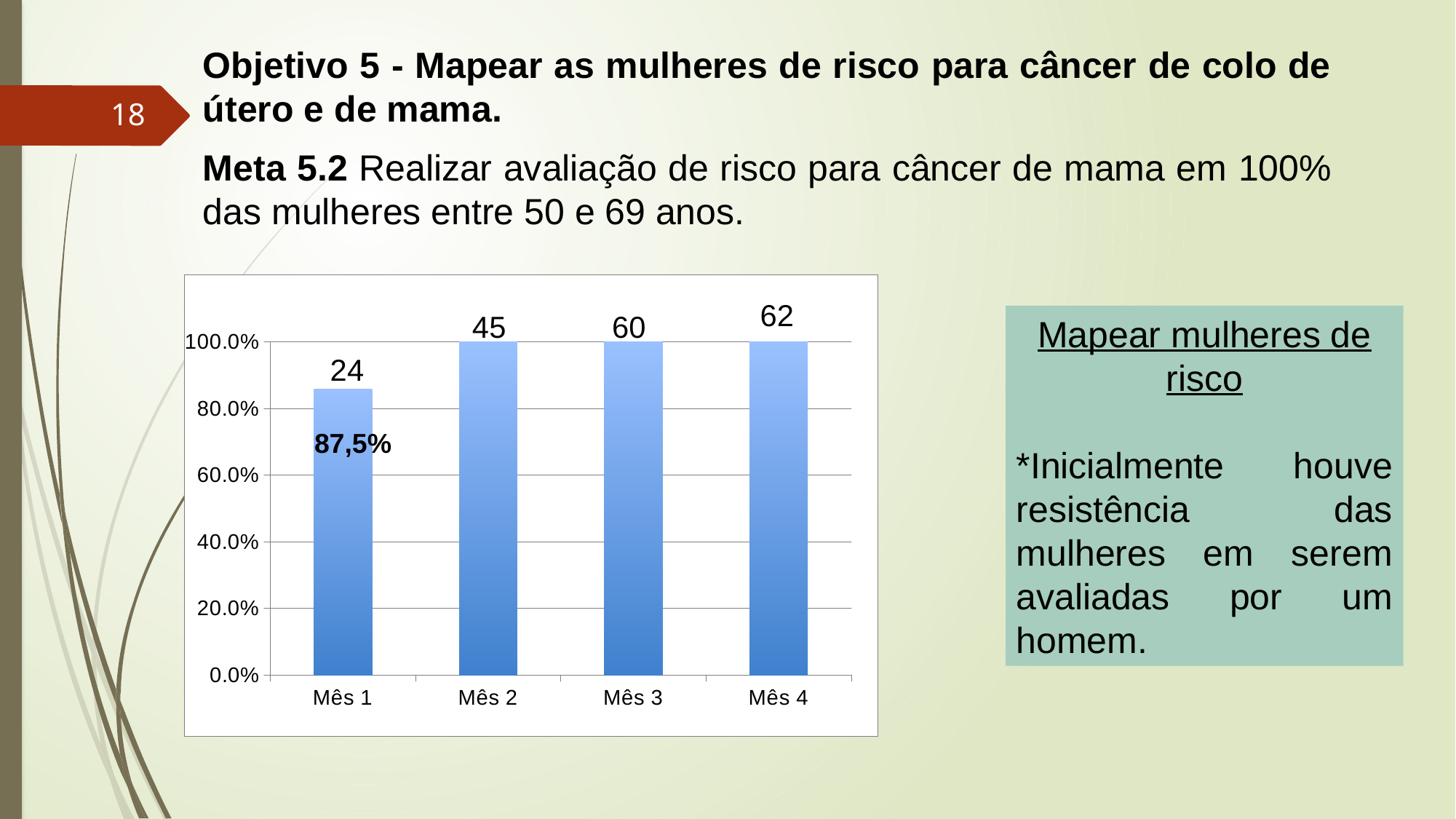
How many months are shown on the x axis? 4 What kind of chart is shown on the slide? bar chart Which month has the highest number printed above its bar? Mês 4 What number is printed above the bar for Mês 1? 24 What percentage does the bar for Mês 3 reach on the y axis? 100.0% What number is printed above the bar for Mês 3? 60 Is the bar for Mês 1 greater or less than 80.0%? greater Which month has the lowest bar? Mês 1 What number is printed above the bar for Mês 2? 45 What number is printed above the bar for Mês 4? 62 What is the difference between the numbers printed above the bars for Mês 4 and Mês 1? 38 What percentage is printed inside the bar for Mês 1? 87,5%